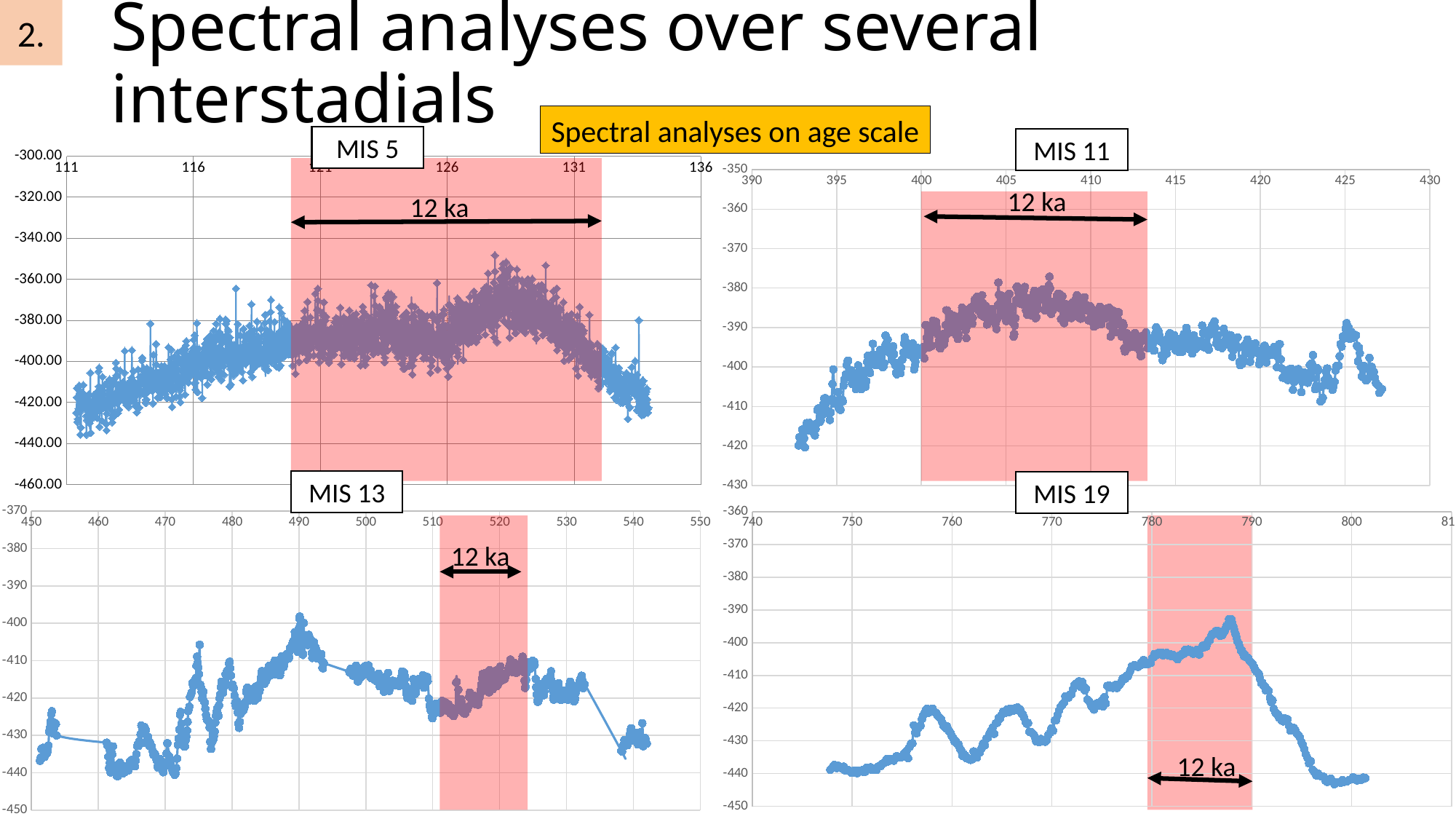
In the MIS 19 chart, do the values rise or fall between 790 and 800 on the x axis? fall Which chart reaches a higher peak value, MIS 5 or MIS 11? MIS 5 What kind of chart is the MIS 19 chart? line chart In the MIS 5 chart, do the values rise or fall between 111 and 121 on the x axis? rise In the MIS 11 chart, is the lowest plotted value greater or less than -410? less How many charts are shown on the slide? 4 In the MIS 11 chart, is the highest plotted value greater or less than -390? greater In the MIS 19 chart, are the values around 800 greater or less than -430? less What duration label is written above the shaded interval in each chart? 12 ka